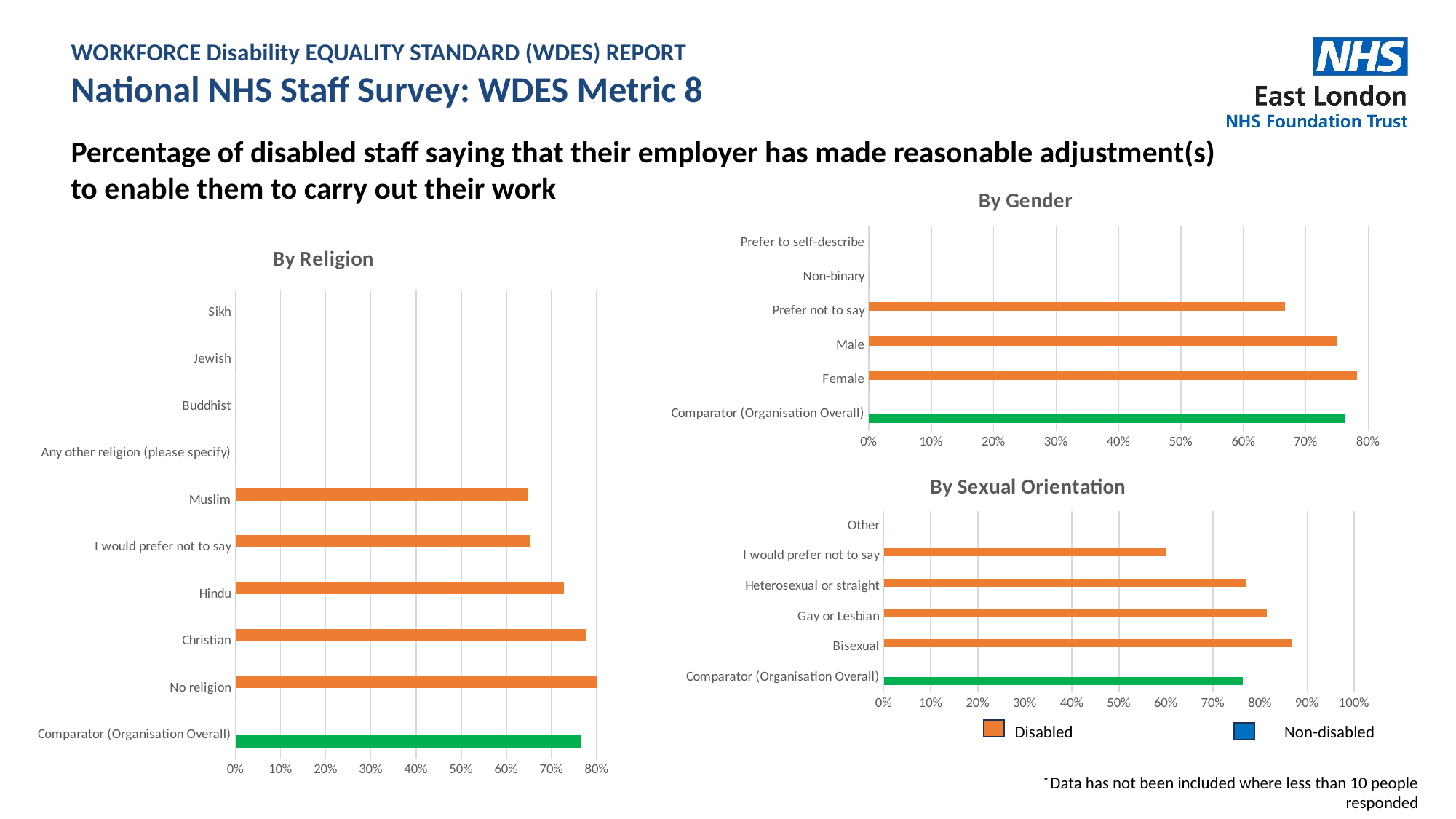
How many entries does the legend below the By Sexual Orientation chart list? 2 In the By Gender chart, is the value for Prefer not to say greater or less than 60%? greater In the By Religion chart, is the value for Hindu greater or less than 70%? greater In the By Sexual Orientation chart, which is larger, the value for Gay or Lesbian or the value for Heterosexual or straight? Gay or Lesbian In the By Religion chart, which category has the longest bar? No religion In the By Sexual Orientation chart, which category has the longest bar? Bisexual In the By Religion chart, which is larger, the value for Christian or the value for Hindu? Christian In the By Gender chart, which is larger, the value for Male or the value for Prefer not to say? Male How many categories are listed on the vertical axis of the By Religion chart? 10 In the By Religion chart, is the value for Muslim greater or less than 70%? less In the By Gender chart, which category has the longest bar? Female